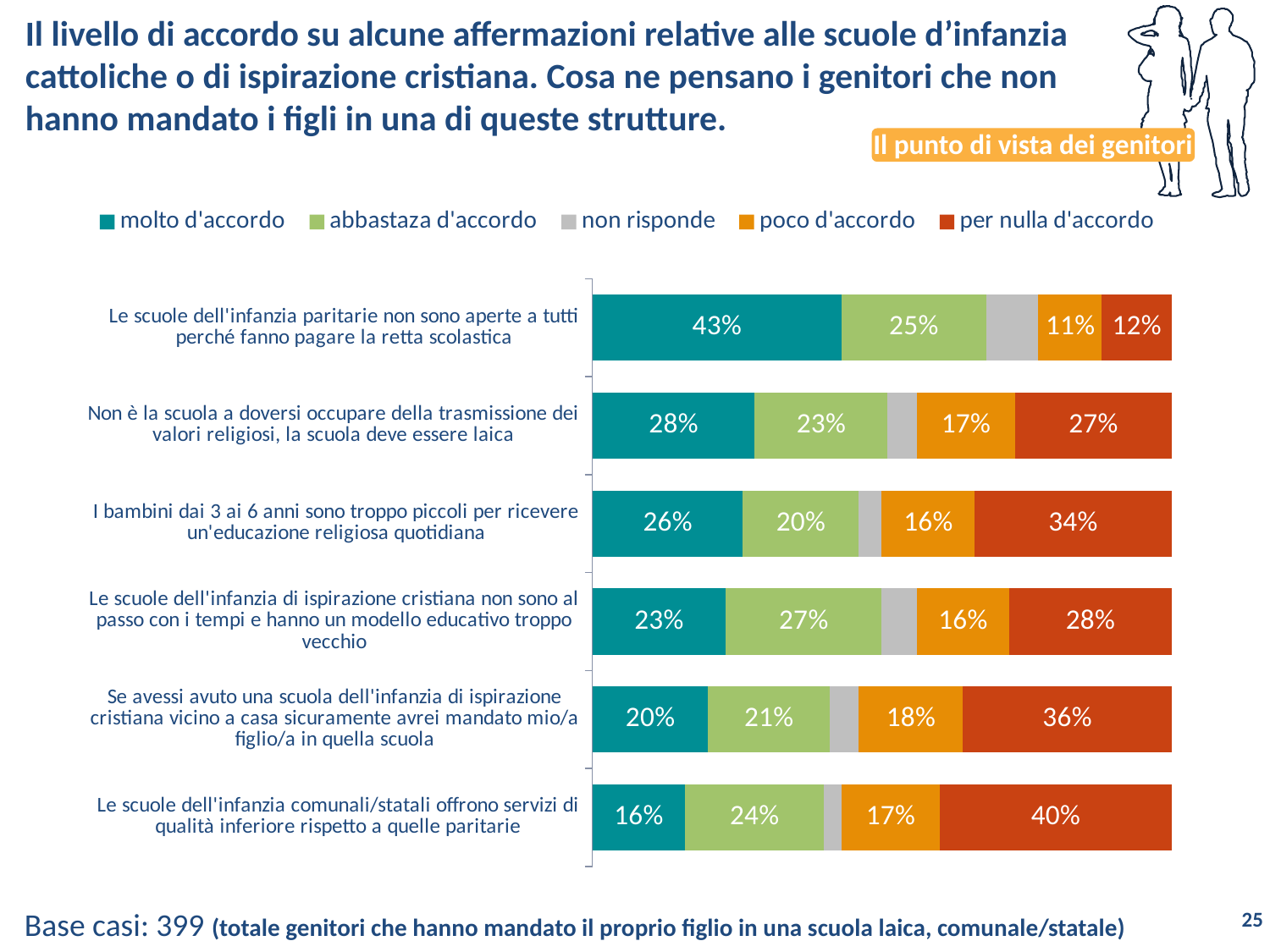
Which colour represents 'non risponde' in the chart? grey What is the 'molto d'accordo' value for the statement 'Le scuole dell'infanzia paritarie non sono aperte a tutti perché fanno pagare la retta scolastica'? 43% What is the 'per nulla d'accordo' value for the statement 'Le scuole dell'infanzia comunali/statali offrono servizi di qualità inferiore rispetto a quelle paritarie'? 40% How many statements (categories) are plotted in the chart? 6 Which statement has the lowest 'per nulla d'accordo' value? Le scuole dell'infanzia paritarie non sono aperte a tutti perché fanno pagare la retta scolastica Which statement has the highest 'molto d'accordo' value? Le scuole dell'infanzia paritarie non sono aperte a tutti perché fanno pagare la retta scolastica What is the 'abbastaza d'accordo' value for the statement 'I bambini dai 3 ai 6 anni sono troppo piccoli per ricevere un'educazione religiosa quotidiana'? 20% What kind of chart is shown on the slide? stacked bar chart How many series does the legend list? 5 What is the difference between the 'per nulla d'accordo' value and the 'molto d'accordo' value for the statement 'Le scuole dell'infanzia comunali/statali offrono servizi di qualità inferiore rispetto a quelle paritarie'? 24% For the statement 'Non è la scuola a doversi occupare della trasmissione dei valori religiosi, la scuola deve essere laica', which is larger: 'molto d'accordo' or 'per nulla d'accordo'? molto d'accordo What is the 'poco d'accordo' value for the statement 'Se avessi avuto una scuola dell'infanzia di ispirazione cristiana vicino a casa sicuramente avrei mandato mio/a figlio/a in quella scuola'? 18%